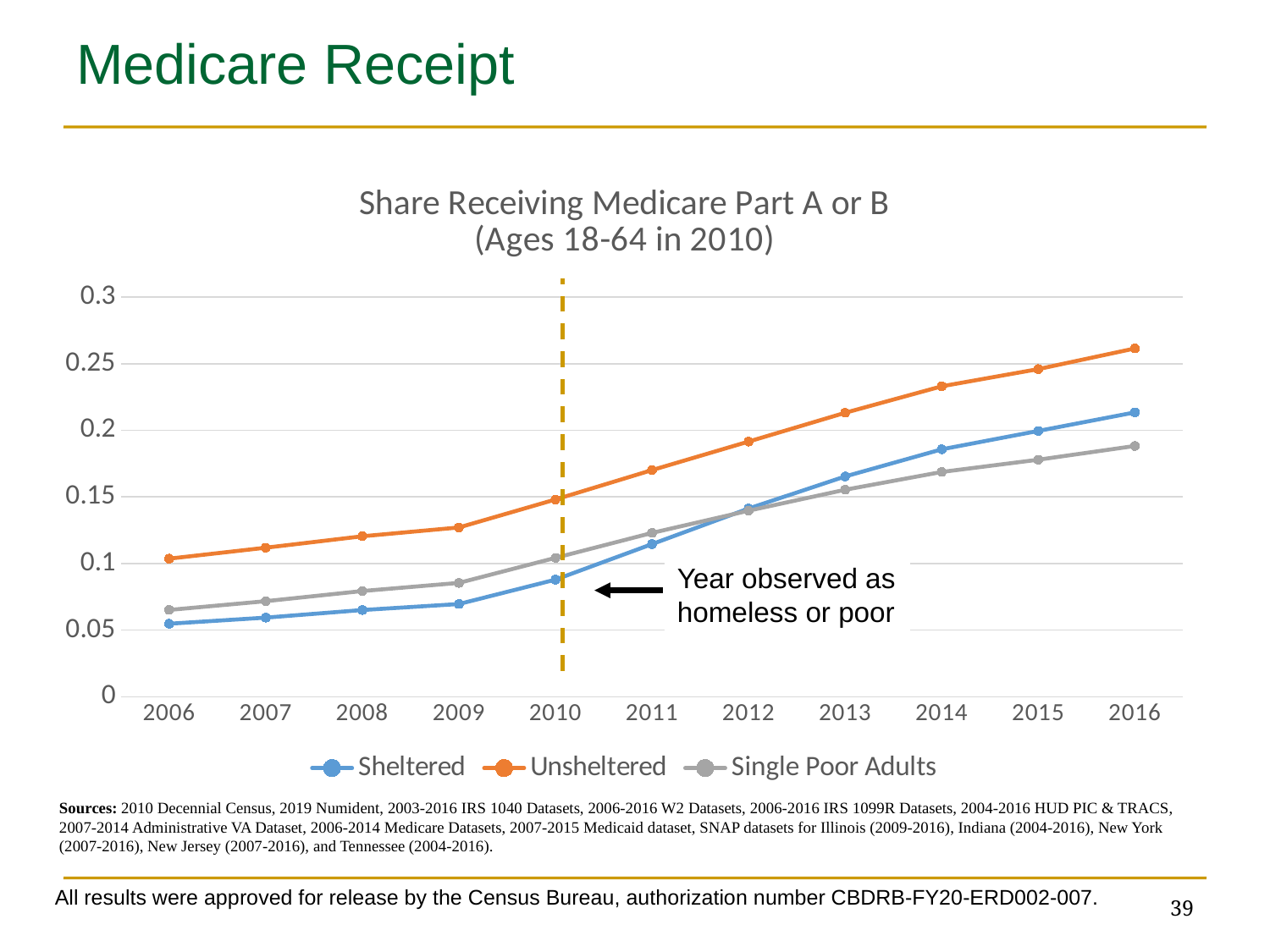
Is the value for Unsheltered in 2016 greater or less than 0.25? greater What kind of chart is shown on the slide? line chart Do the values for the Unsheltered series rise or fall from 2006 to 2016? rise Is the value for Single Poor Adults in 2016 greater or less than 0.2? less Which series has the highest value in 2016? Unsheltered In 2016, which is larger: the value for Sheltered or for Single Poor Adults? Sheltered What is the title of the chart? Share Receiving Medicare Part A or B (Ages 18-64 in 2010) How many series does the legend list? 3 Which series has the lowest value in 2006? Sheltered Is the value for Sheltered in 2010 greater or less than 0.1? less How many years are plotted along the x axis? 11 In 2009, which is larger: the value for Sheltered or for Single Poor Adults? Single Poor Adults